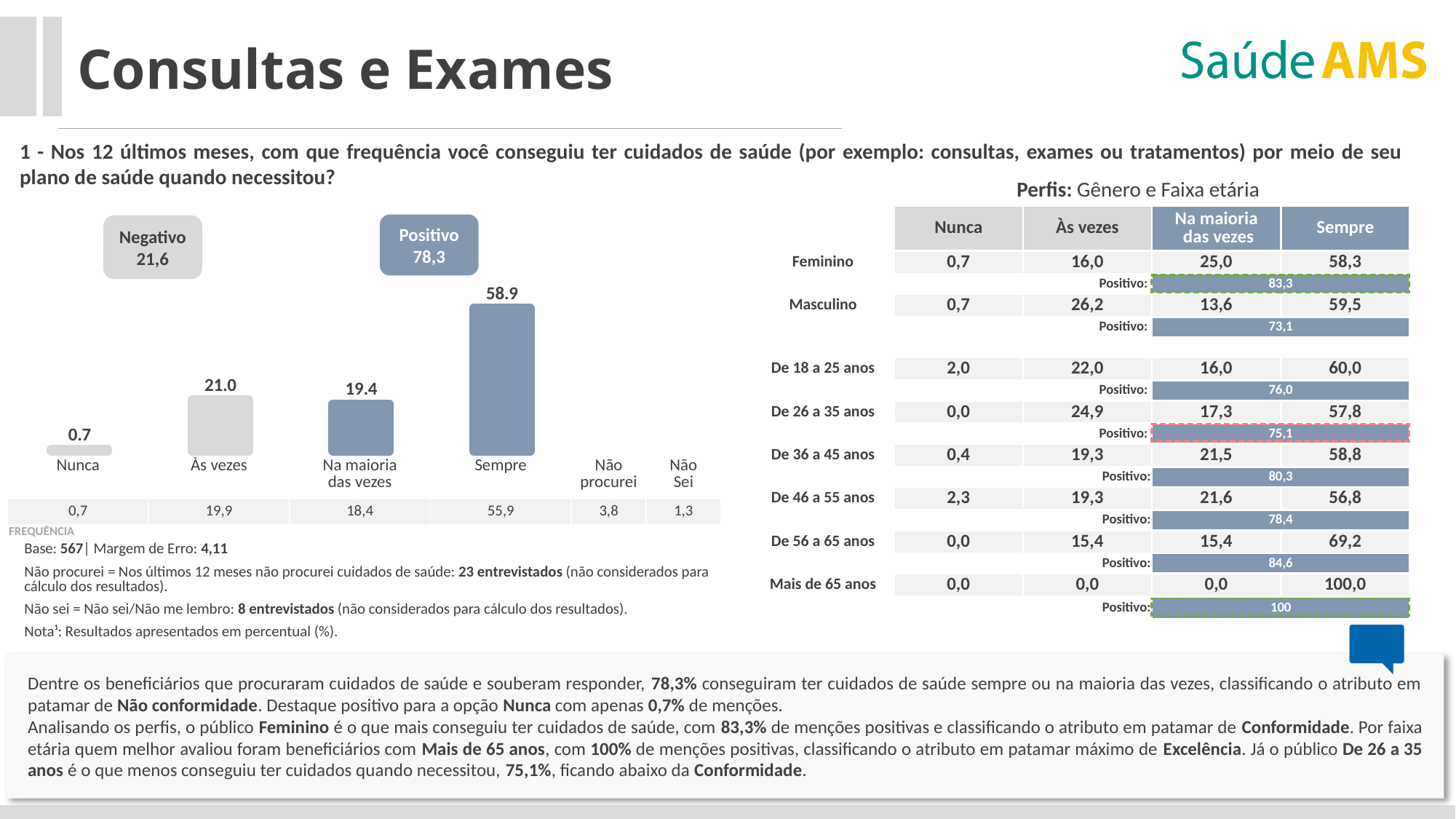
What kind of chart is shown on the left of the slide? bar chart In the bar chart, what is the value for Na maioria das vezes? 19.4 In the bar chart, which category has the highest value? Sempre In the bar chart, what is the difference between the values for Sempre and Às vezes? 37.9 In the bar chart, which is larger: the value for Às vezes or the value for Na maioria das vezes? Às vezes In the bar chart, what is the difference between the values for Sempre and Na maioria das vezes? 39.5 What value is shown in the Positivo box above the bar chart? 78,3 In the bar chart, which category has the lowest value? Nunca How many bars are plotted in the bar chart? 4 In the bar chart, what is the value for Nunca? 0.7 In the bar chart, what is the value for Às vezes? 21.0 In the bar chart, what is the value for Sempre? 58.9